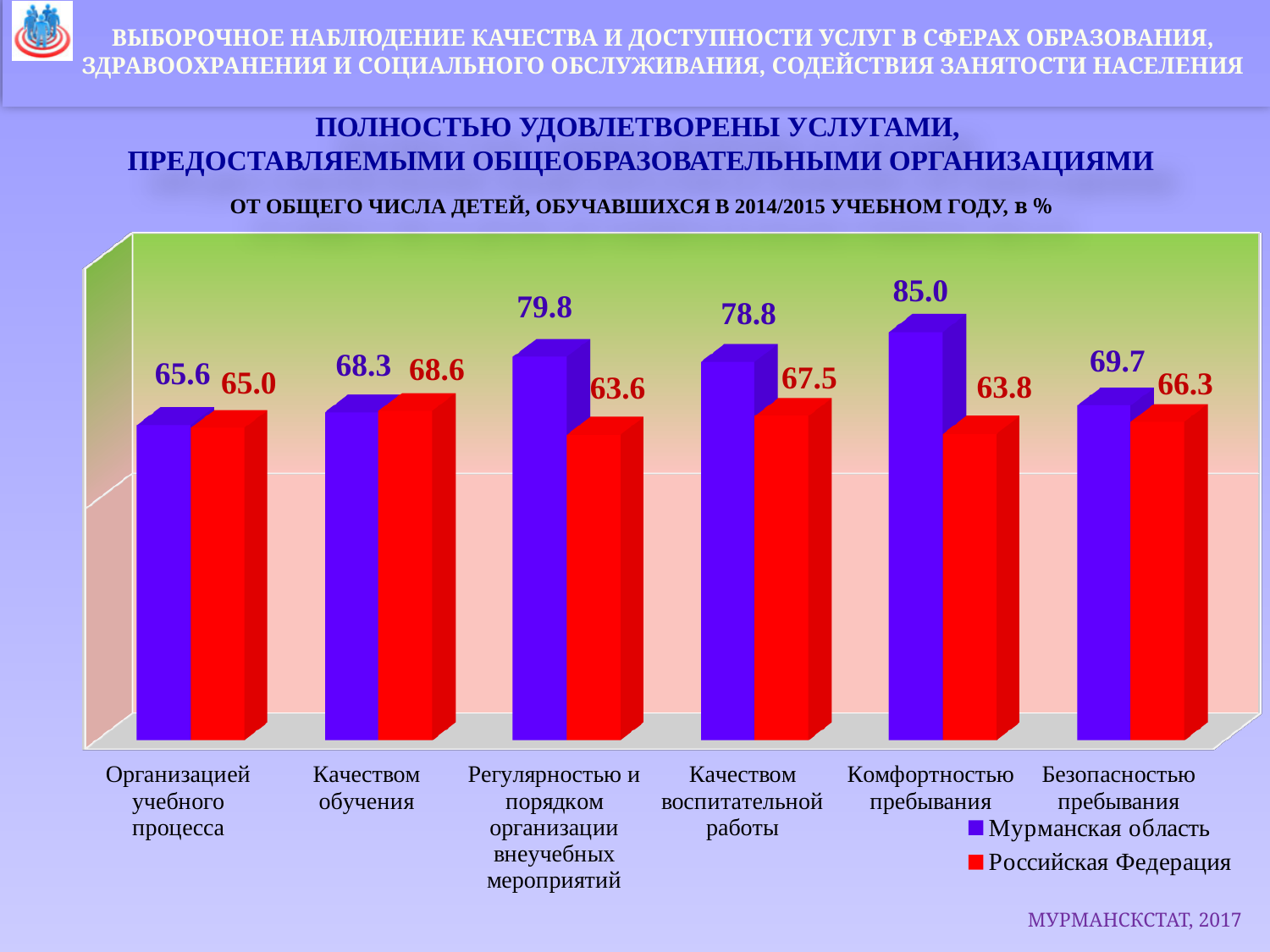
What kind of chart is shown on the slide? bar chart What is the value for Мурманская область for Комфортностью пребывания? 85.0 What is the value for Российская Федерация for Безопасностью пребывания? 66.3 Which is larger for Качеством обучения: Мурманская область or Российская Федерация? Российская Федерация What is the value for Мурманская область for Качеством воспитательной работы? 78.8 Which category has the highest value for Мурманская область? Комфортностью пребывания What is the difference between Мурманская область and Российская Федерация for Комфортностью пребывания? 21.2 What is the value for Российская Федерация for Регулярностью и порядком организации внеучебных мероприятий? 63.6 How many categories are shown on the x axis? 6 Which category has the lowest value for Российская Федерация? Регулярностью и порядком организации внеучебных мероприятий How many series does the legend list? 2 Which colour represents Российская Федерация in the chart? red